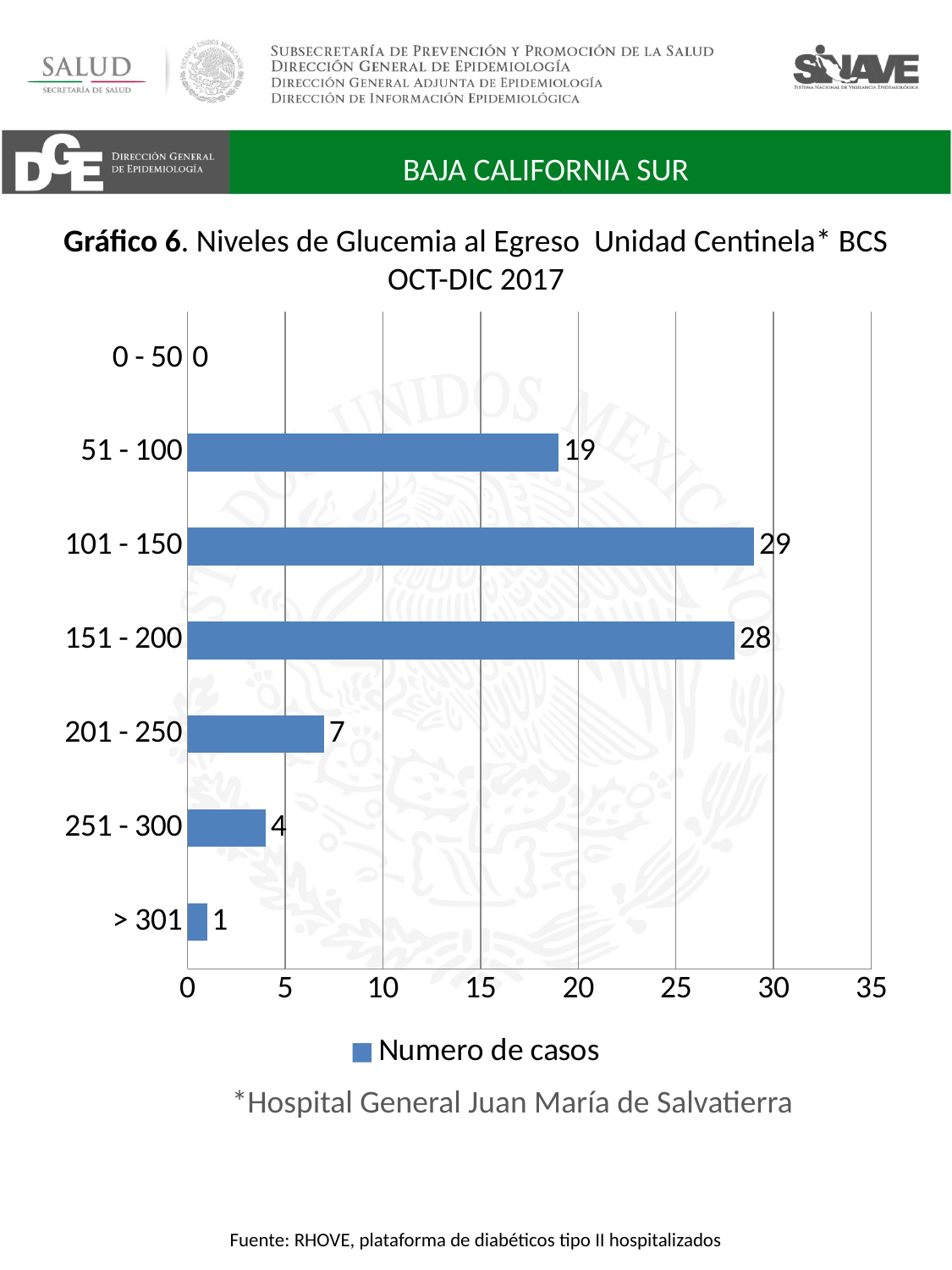
How many series does the legend list? 1 What is the name of the series shown in the legend? Numero de casos What is the number of cases for the 51 - 100 category? 19 What is the total number of cases across all categories? 88 What is the number of cases for the 101 - 150 glucose level category? 29 What kind of chart is shown on the slide? Bar chart Which category has more cases, 201 - 250 or 251 - 300? 201 - 250 Which glucose level category has the highest number of cases? 101 - 150 What is the difference in number of cases between the 151 - 200 and 201 - 250 categories? 21 How many glucose level categories are shown on the chart? 7 Which glucose level category has the lowest number of cases? 0 - 50 What is the number of cases for the > 301 category? 1